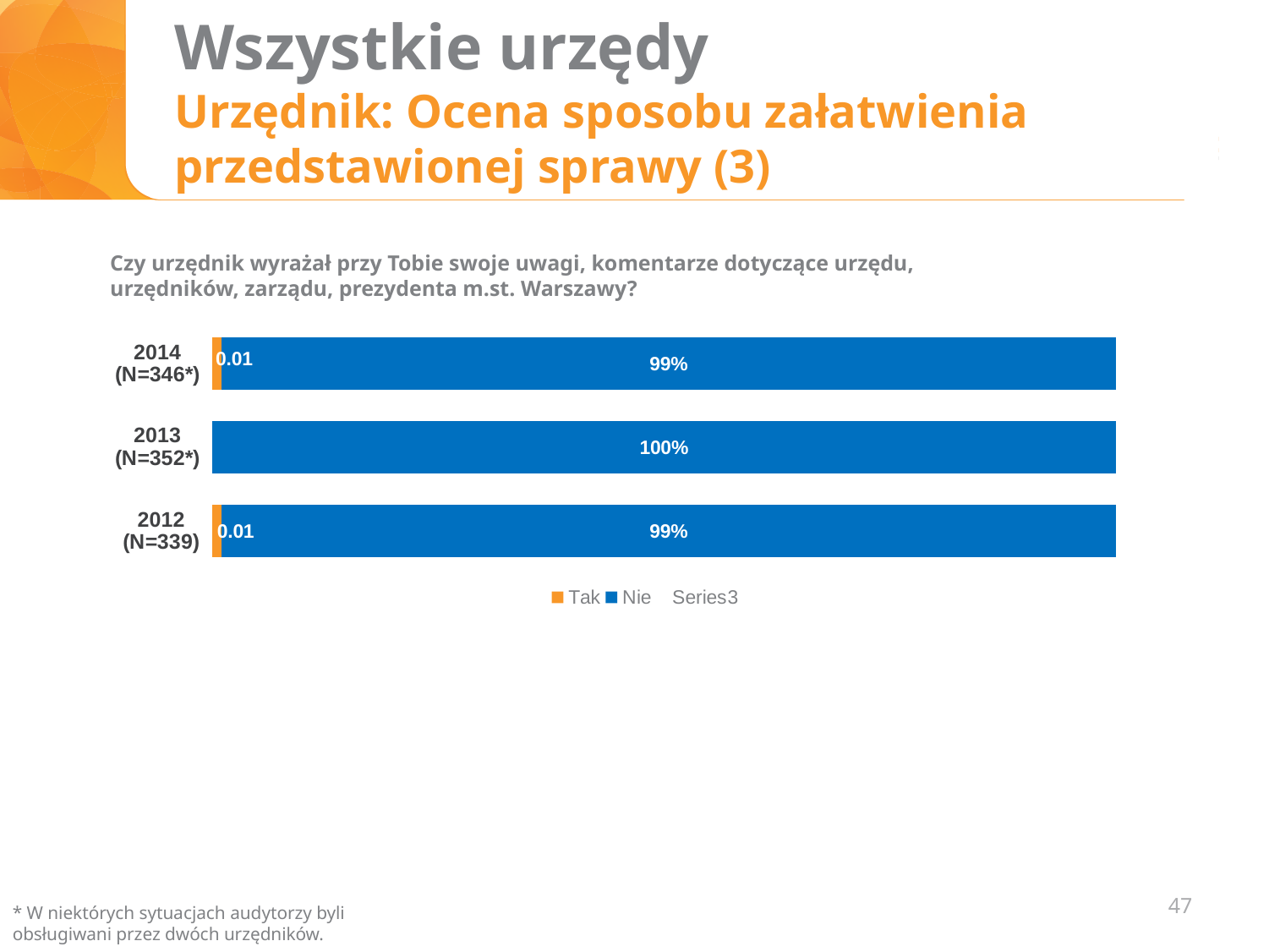
Is the "Nie" value for 2013 (N=352*) larger or smaller than the "Nie" value for 2014 (N=346*)? larger What data label is shown for "Tak" in 2014 (N=346*)? 0.01 What is the value of "Nie" for 2012 (N=339)? 99% What data label is shown for "Tak" in 2012 (N=339)? 0.01 Which year has the highest value for "Nie"? 2013 (N=352*) Which colour represents the "Nie" series in the chart? Blue What is the value of "Nie" for 2014 (N=346*)? 99% How many years (categories) are shown in the chart? 3 What is the difference between the "Nie" value for 2013 (N=352*) and the "Nie" value for 2012 (N=339)? 1% What type of chart is shown on the slide? Stacked bar chart What is the value of "Nie" for 2013 (N=352*)? 100% How many series does the legend list? 3